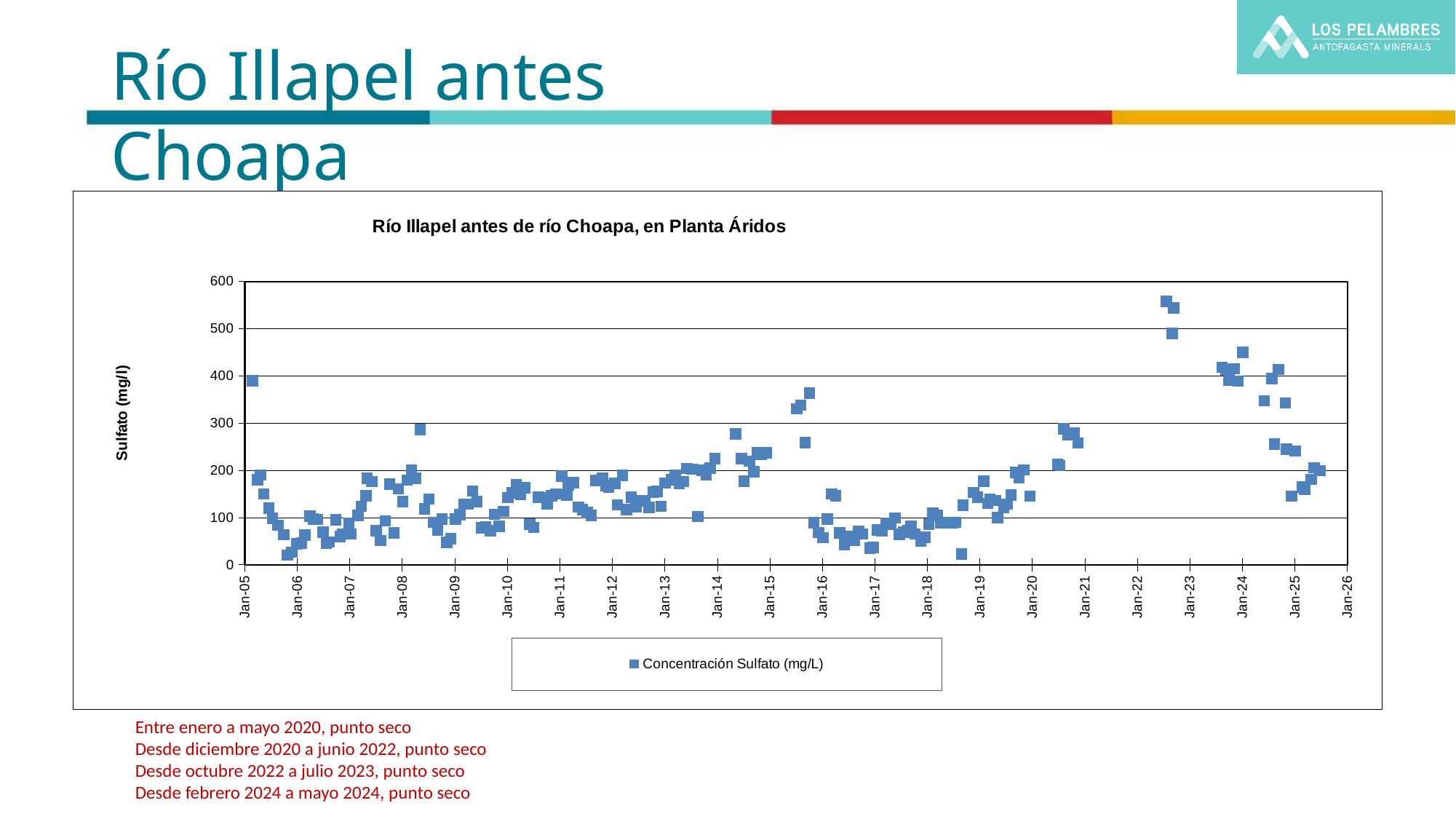
Which is higher: the first point at Jan-05 or the points plotted around Jan-06? the point at Jan-05 What kind of chart is shown on the slide? scatter chart Between Jan-05 and Jan-06, do the plotted values rise or fall? fall What is the legend entry for the plotted series? Concentración Sulfato (mg/L) How many series does the legend list? 1 How many year labels are shown on the x axis, from Jan-05 to Jan-26? 22 What is the title of the chart? Río Illapel antes de río Choapa, en Planta Áridos Are the values plotted just before Jan-24 greater or less than 300? greater Are the values plotted around Jan-17 greater or less than 200? less Is the first plotted value, at Jan-05, greater or less than 300? greater